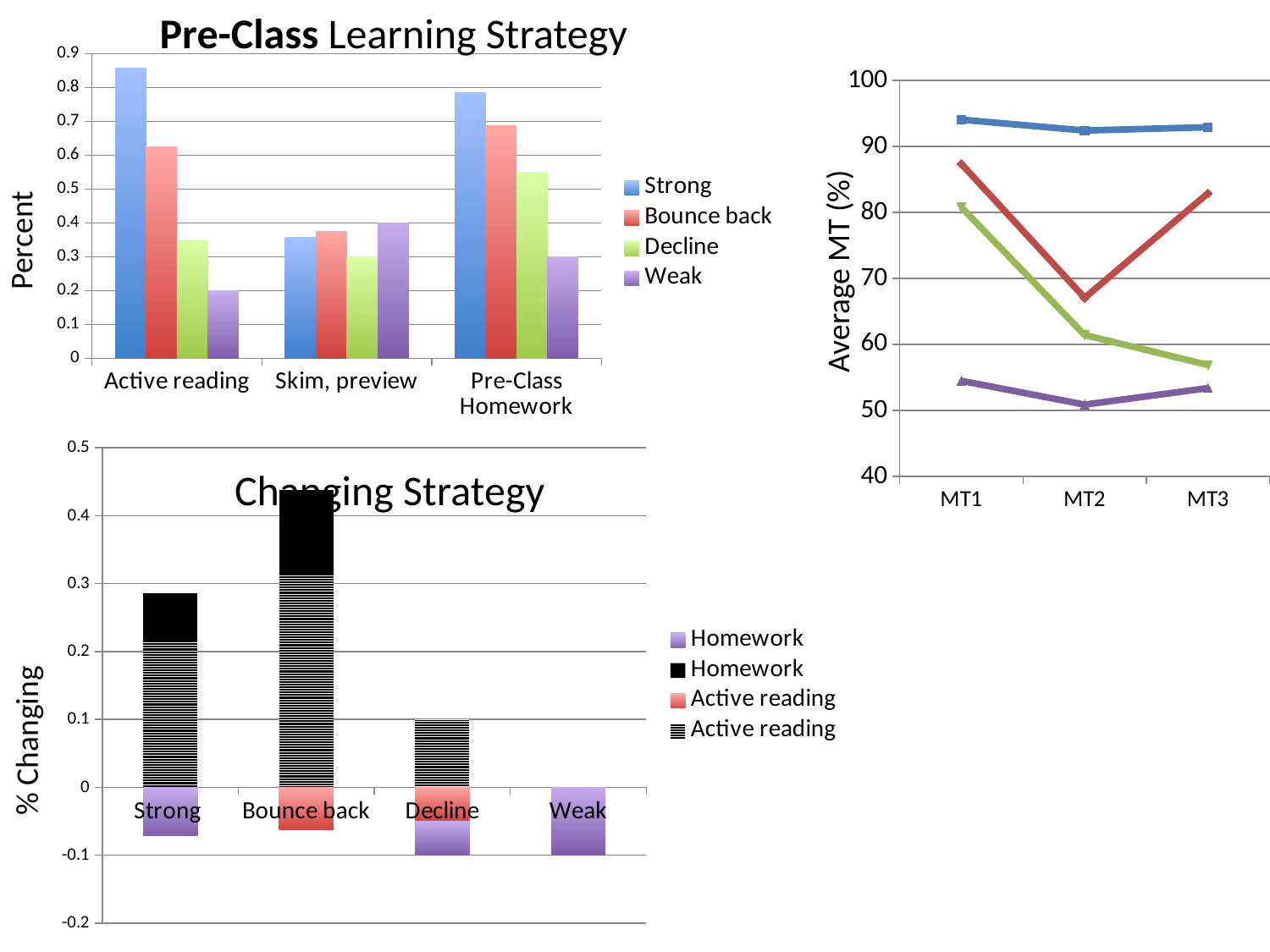
What kind of chart is the Changing Strategy chart? bar chart In the Pre-Class Learning Strategy chart, is the Strong value for Active reading greater or less than 0.8? greater How many series does the legend of the Pre-Class Learning Strategy chart list? 4 In the Changing Strategy chart, which category has the tallest positive stacked bar? Bounce back In the Pre-Class Learning Strategy chart, which series has the lowest value for Pre-Class Homework? Weak In the Pre-Class Learning Strategy chart, which series has the highest value for Active reading? Strong In the Pre-Class Learning Strategy chart, is the Weak value for Active reading greater or less than 0.3? less In the line chart on the right, is the value of the blue line at MT1 greater or less than 90? greater In the Pre-Class Learning Strategy chart, which is larger for Pre-Class Homework: Decline or Weak? Decline In the line chart on the right, does the green line rise or fall from MT1 to MT3? fall How many entries does the legend of the Changing Strategy chart list? 4 How many categories are shown on the x axis of the Pre-Class Learning Strategy chart? 3